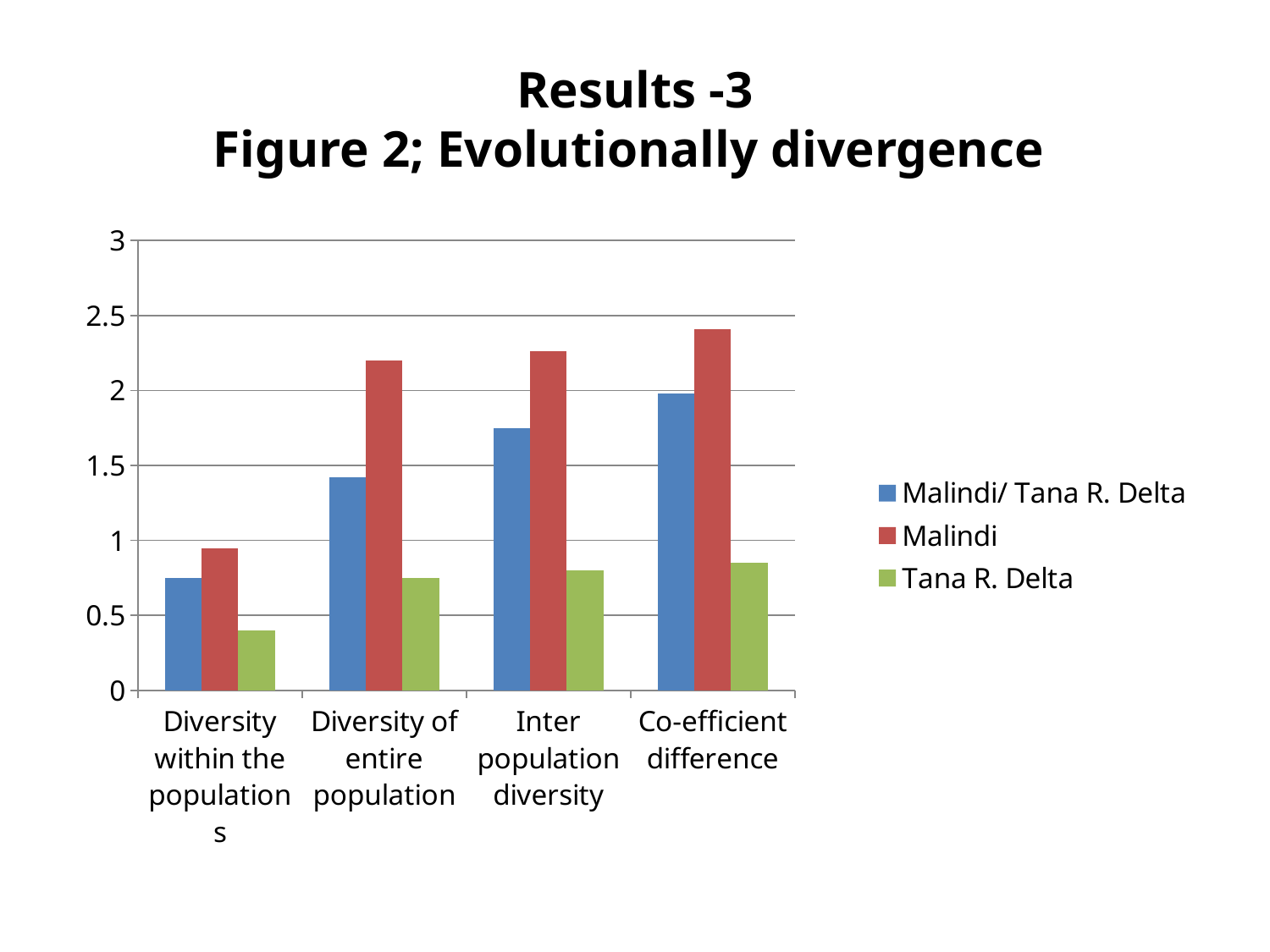
For which category is the Malindi/ Tana R. Delta series highest? Co-efficient difference How many series does the legend list? 3 What kind of chart is shown on the slide? bar chart Which series has the highest value for Co-efficient difference? Malindi For which category is the Malindi series lowest? Diversity within the populations How many categories are shown on the x axis? 4 Which series has the lowest value for Diversity of entire population? Tana R. Delta Is the Malindi value for Diversity of entire population greater or less than 2? greater Is the Malindi/ Tana R. Delta value for Inter population diversity greater or less than 1.5? greater Which is larger for Inter population diversity: Malindi or Tana R. Delta? Malindi Is the Tana R. Delta value for Diversity within the populations greater or less than 0.5? less Do the Malindi/ Tana R. Delta values rise or fall from left to right across the categories? rise